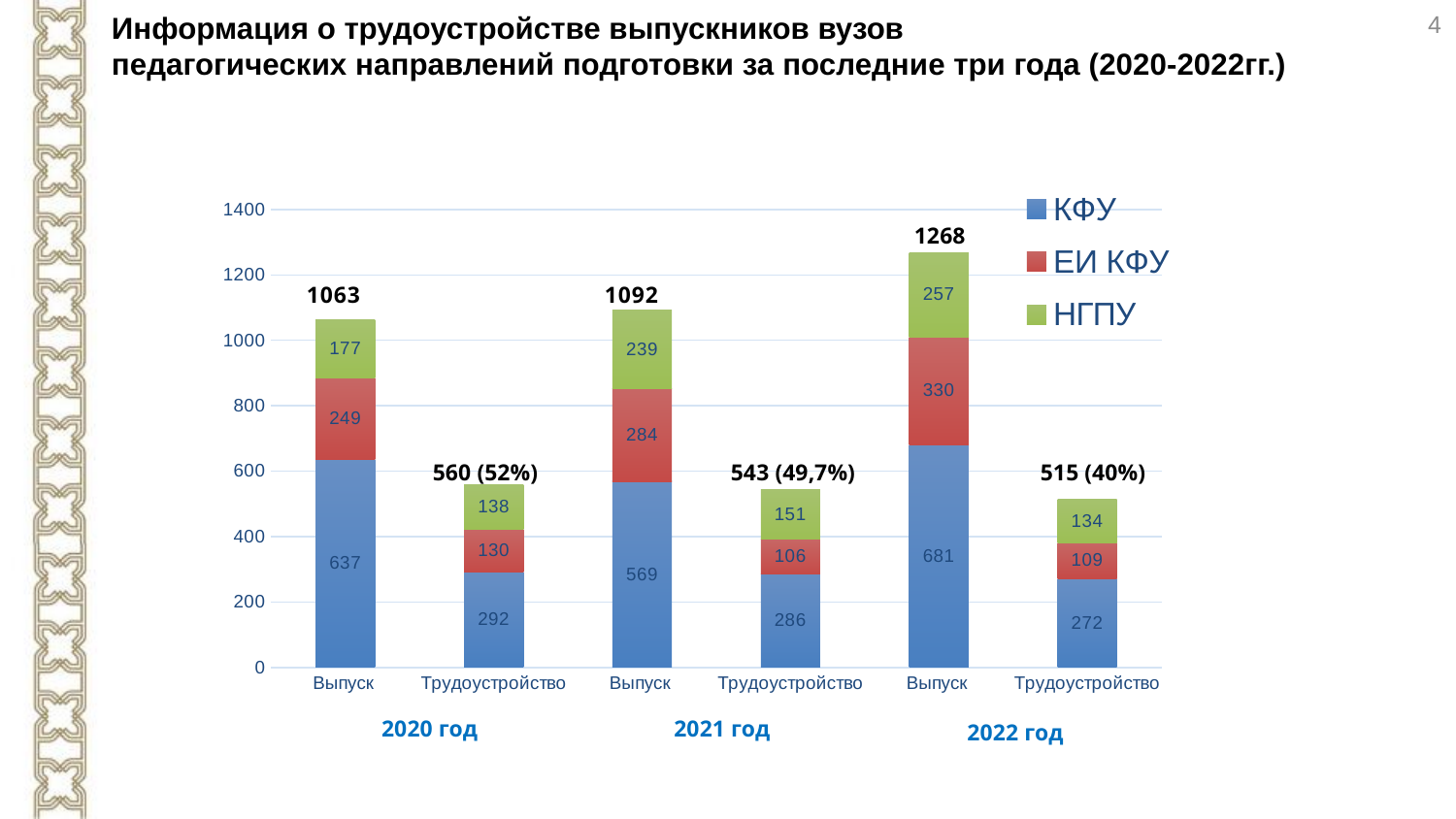
Which bar has the lowest total? Трудоустройство 2022 год What is the ЕИ КФУ value for Выпуск in 2022 год? 330 What is the total of the Выпуск bar for 2022 год? 1268 What is the total label shown above the Трудоустройство bar for 2021 год? 543 (49,7%) What kind of chart is shown on the slide? Stacked bar chart Which is larger: the НГПУ value for Выпуск in 2021 год or the НГПУ value for Выпуск in 2020 год? Выпуск 2021 год What is the difference between the КФУ values for Выпуск in 2022 год and 2020 год? 44 How many series does the legend list? 3 How many bars are plotted in the chart? 6 What is the КФУ value for Выпуск in 2020 год? 637 What is the НГПУ value for Трудоустройство in 2021 год? 151 Which bar has the highest total? Выпуск 2022 год